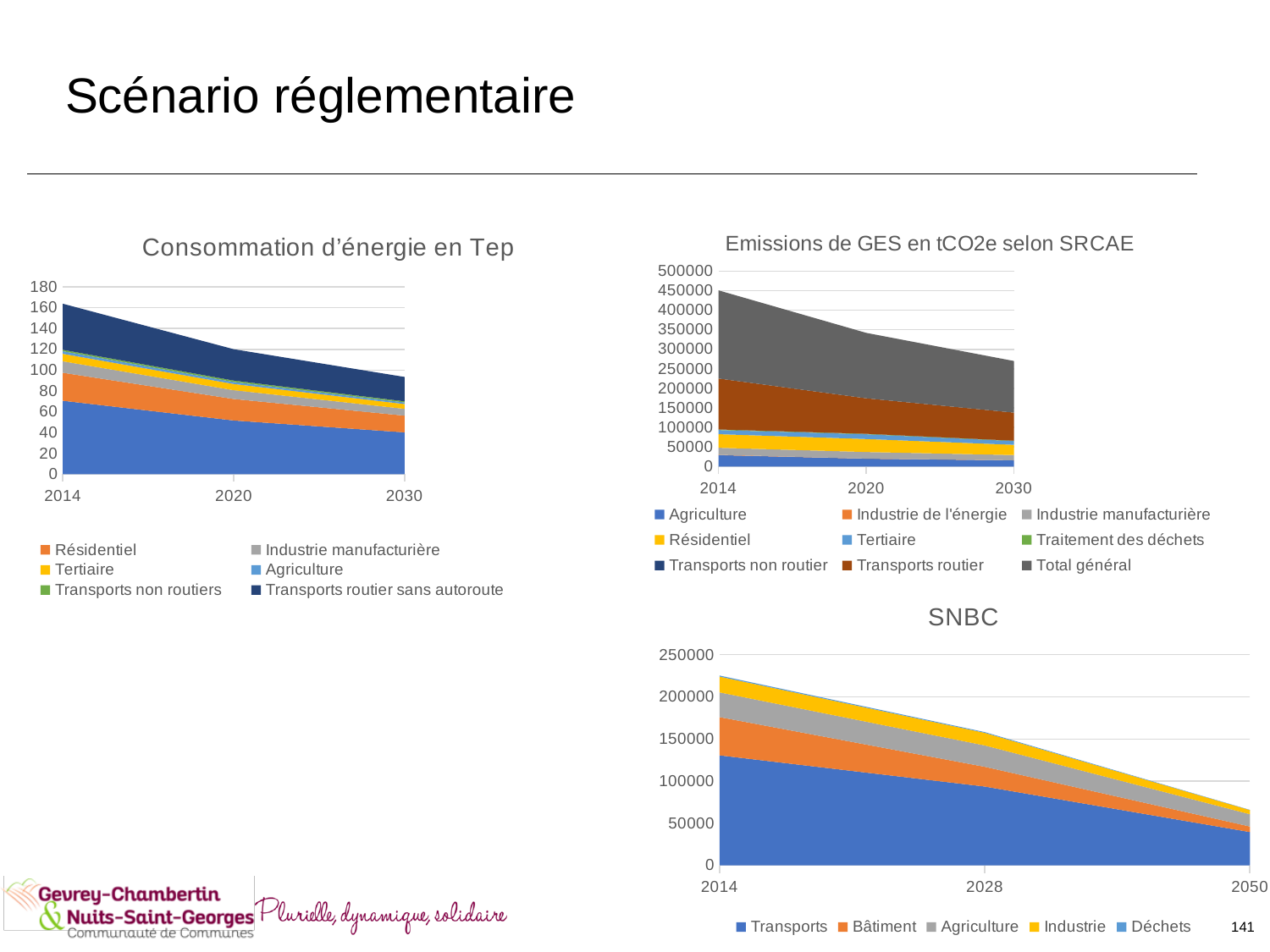
What kind of chart is the 'Consommation d'énergie en Tep' chart? Stacked area chart In the 'Consommation d'énergie en Tep' chart, is the total value in 2014 greater or less than 140? greater In the 'Consommation d'énergie en Tep' chart, does the total consumption rise or fall from 2014 to 2030? Fall How many series does the legend of the 'SNBC' chart list? 5 In the 'SNBC' chart, is the total value in 2050 greater or less than 100000? less In the 'SNBC' chart, do the total emissions rise or fall from 2014 to 2050? Fall In the 'Emissions de GES en tCO2e selon SRCAE' chart, is the top of the stack in 2030 greater or less than 300000? less How many series does the legend of the 'Consommation d'énergie en Tep' chart list? 6 How many years are shown on the x axis of the 'Consommation d'énergie en Tep' chart? 3 What years are shown on the x axis of the 'SNBC' chart? 2014, 2028, 2050 How many series does the legend of the 'Emissions de GES en tCO2e selon SRCAE' chart list? 9